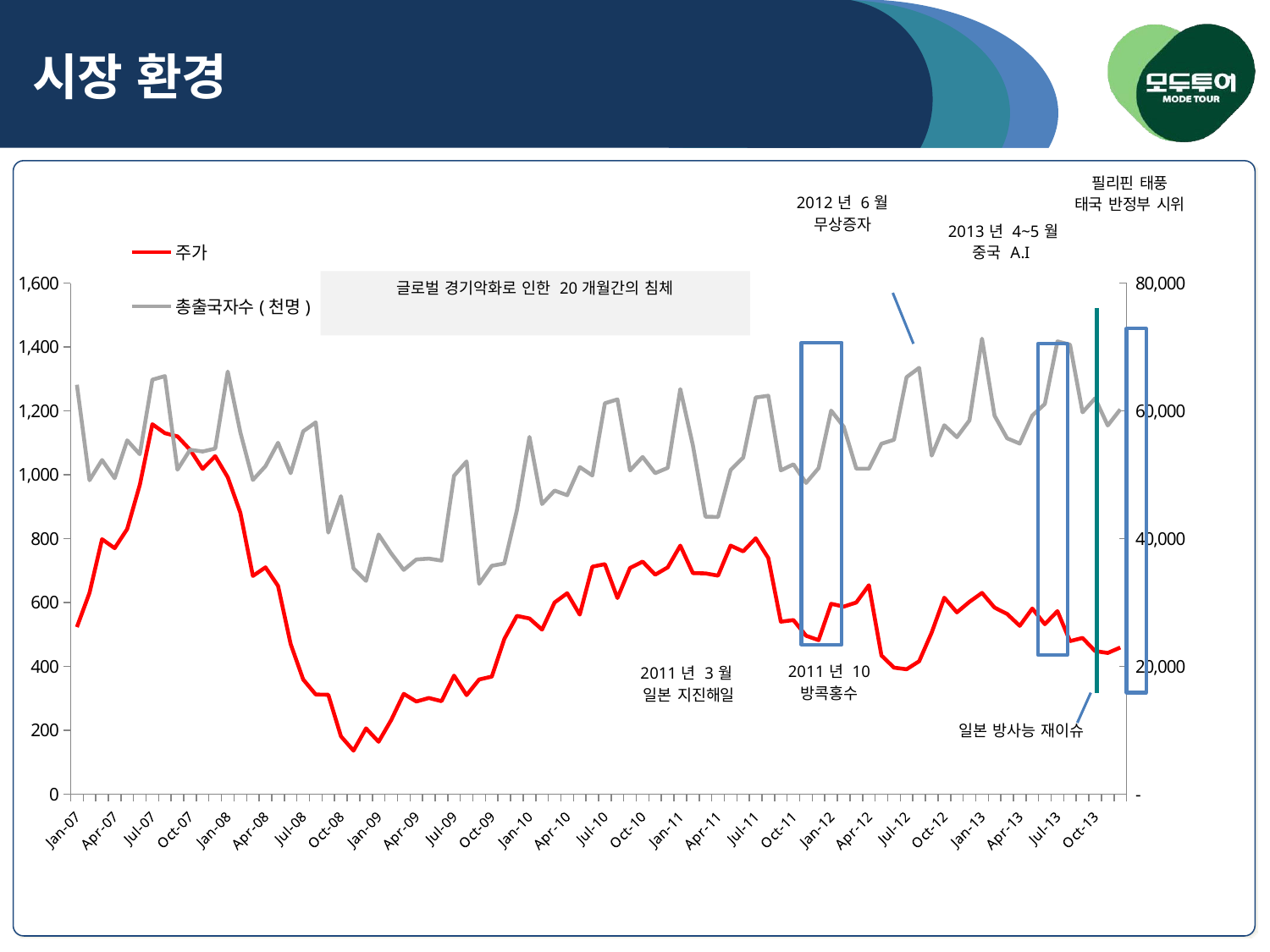
Which series is drawn in red in the chart? 주가 Which is larger for 주가: the value at Jul-07 or the value at Jan-09? Jul-07 Is the value of 총출국자수 (천명) at Jan-07 greater or less than 60,000 on the right axis? greater Does the 주가 series rise or fall between Jan-09 and Jul-11? rise Is the value of 주가 at Jul-07 greater or less than 1,000? greater What is the maximum value shown on the left vertical axis of the chart? 1,600 Does the 주가 series rise or fall between Jul-07 and Jan-09? fall What kind of chart is shown on the slide? line chart How many series does the chart's legend list? 2